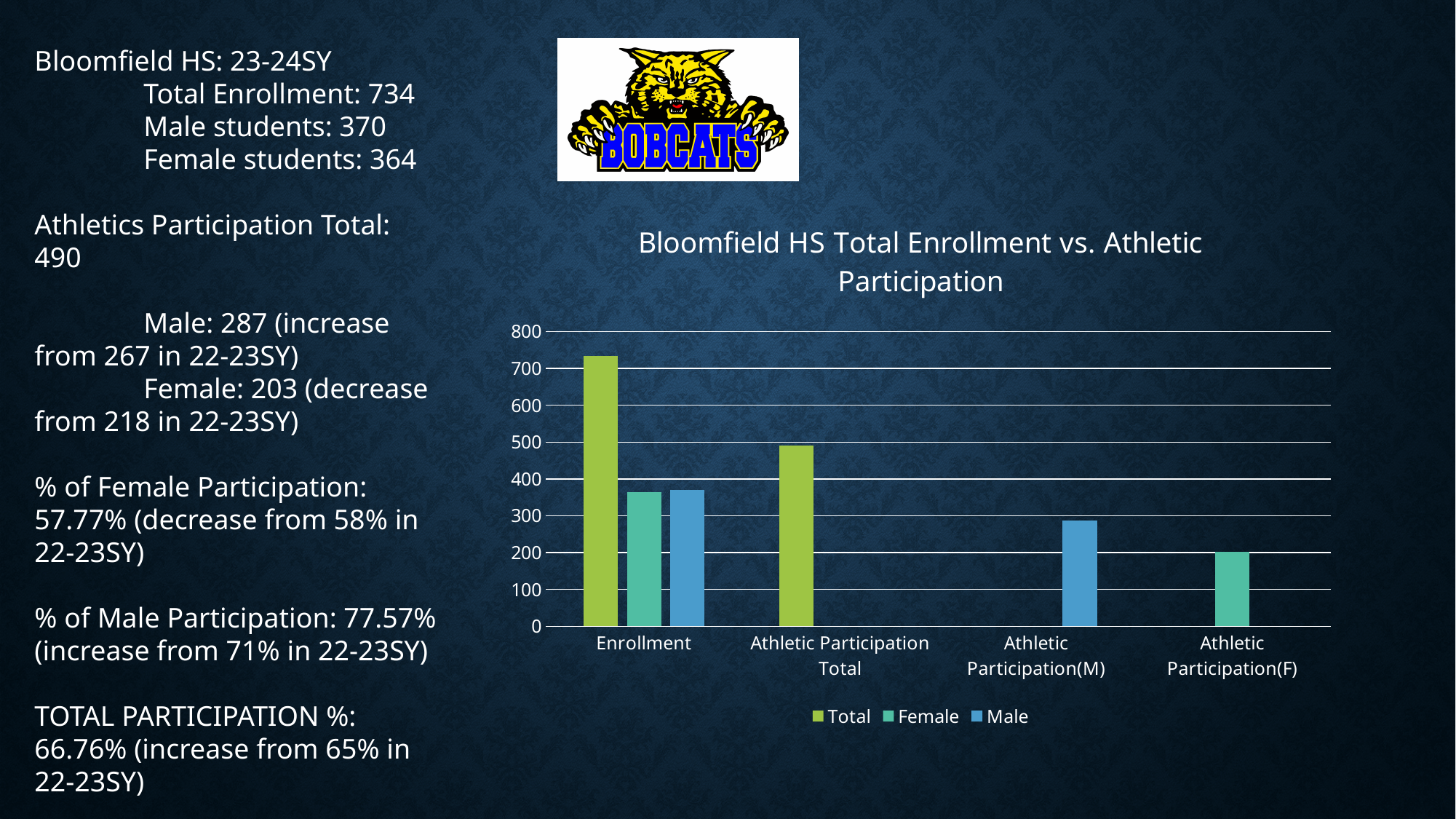
Which bar in the chart is the tallest? Total for Enrollment What is the title of the chart? Bloomfield HS Total Enrollment vs. Athletic Participation What kind of chart is shown on the slide? bar chart Is the Male value for Athletic Participation(M) greater or less than 200? greater How many series does the chart legend list? 3 Which bar in the chart is the shortest? Female for Athletic Participation(F) Is the Total value for Enrollment greater or less than 700? greater Is the Female value for Athletic Participation(F) greater or less than 300? less Which is larger, the Male bar for Athletic Participation(M) or the Female bar for Athletic Participation(F)? Male bar for Athletic Participation(M) How many categories are shown on the x axis of the chart? 4